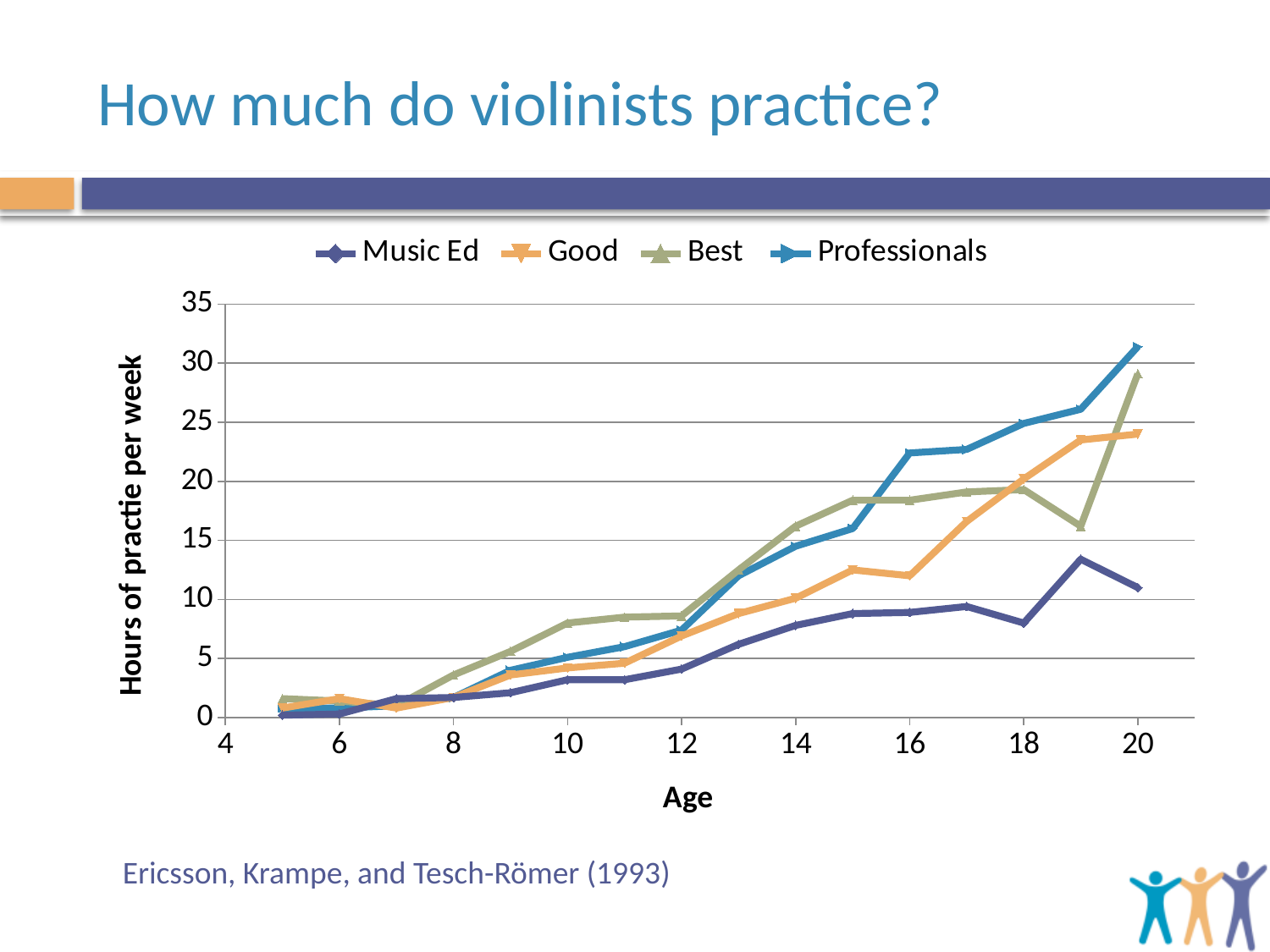
How many series does the legend list? 4 Is the value for Professionals at age 20 greater or less than 25? greater Is the value for Professionals at age 16 greater or less than 20? greater At age 16, which series has the larger value, Professionals or Good? Professionals Which series has the lowest value at age 20? Music Ed What kind of chart is shown on the slide? line chart Is the value for Best at age 19 greater or less than 20? less At age 19, which series has the larger value, Good or Best? Good Do the values for Professionals generally rise or fall as age increases? rise What is the label of the vertical axis? Hours of practie per week Which series has the highest value at age 20? Professionals